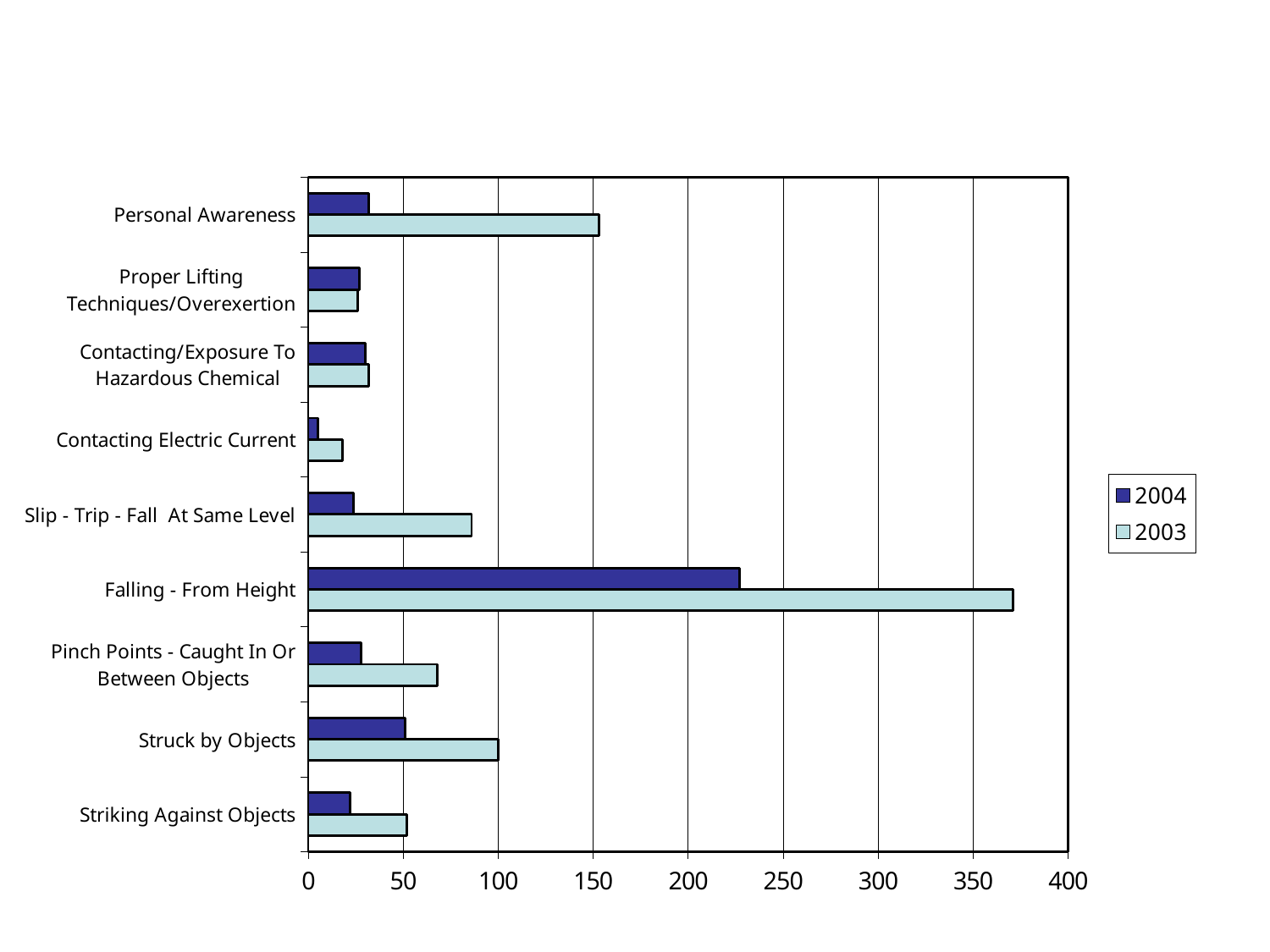
Which category has the highest value for 2004? Falling - From Height Which category has the lowest value for 2003? Contacting Electric Current Is the 2003 value for Personal Awareness greater or less than 100? greater Which series is shown in dark blue in the legend? 2004 For Slip - Trip - Fall At Same Level, which year has the larger value, 2003 or 2004? 2003 What kind of chart is shown on the slide? bar chart Is the 2003 value for Falling - From Height greater or less than 350? greater How many series does the legend list? 2 How many categories are shown on the chart? 9 Which category has the lowest value for 2004? Contacting Electric Current Is the 2004 value for Falling - From Height greater or less than 200? greater Which category has the highest value for 2003? Falling - From Height